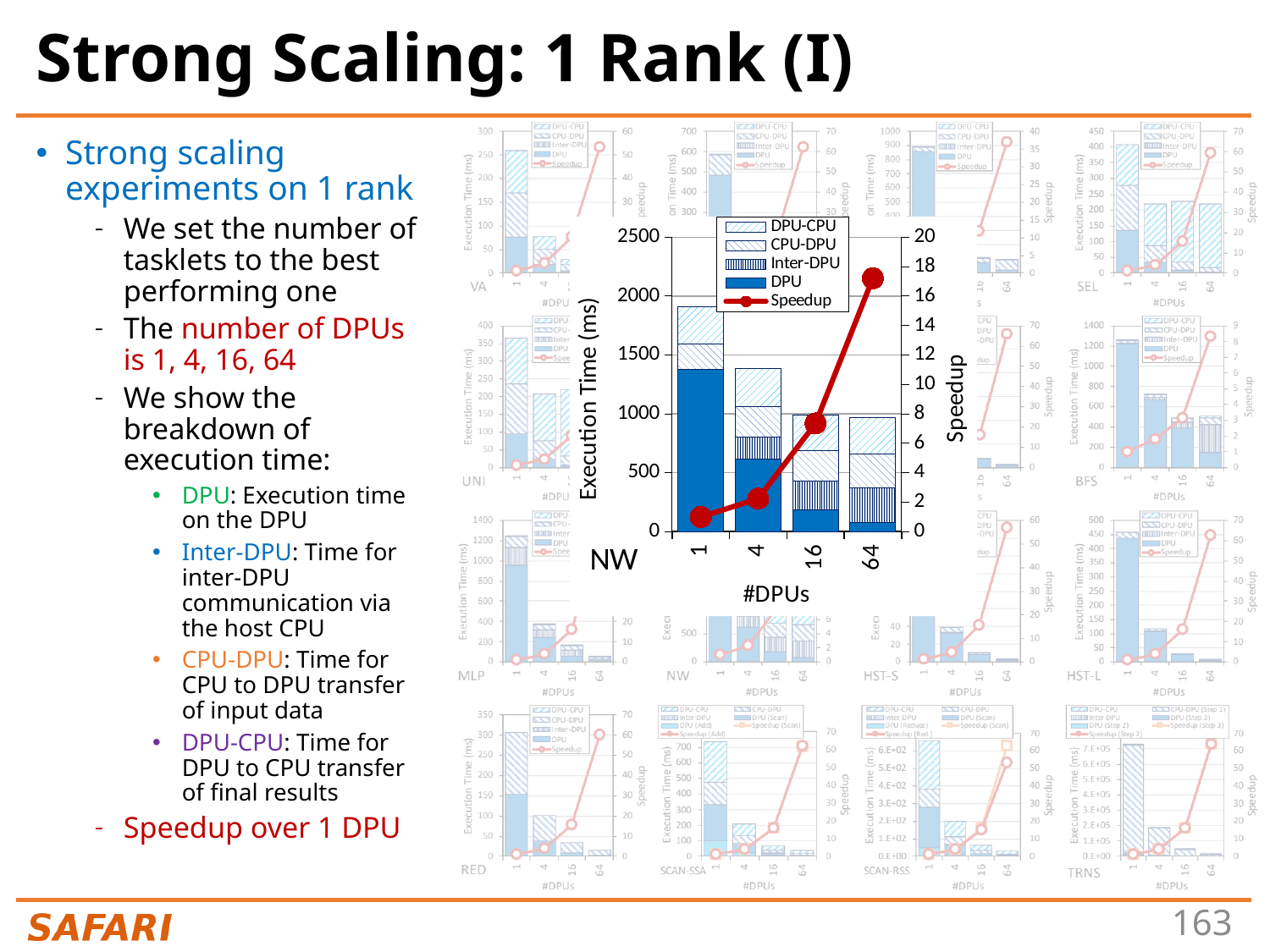
In the large NW chart, which #DPUs value has the highest speedup? 64 What kind of chart is the large NW chart? bar chart (stacked, with a speedup line) What is the title of the left vertical axis of the large NW chart? Execution Time (ms) In the large NW chart, is the speedup for 64 DPUs greater or less than 14? greater In the large NW chart, is the speedup for 4 DPUs greater or less than 4? less In the large NW chart, is the total execution time for 1 DPU greater or less than 1500 ms? greater In the large NW chart, which #DPUs value has the lowest speedup? 1 In the large NW chart, which #DPUs value has the highest total execution time? 1 In the large NW chart, how many series does the legend list? 5 In the large NW chart, does the speedup rise or fall as #DPUs increases from 1 to 64? rises In the large NW chart, which has the larger total execution time: 1 DPU or 16 DPUs? 1 DPU In the large NW chart, how many #DPUs categories are shown on the x axis? 4